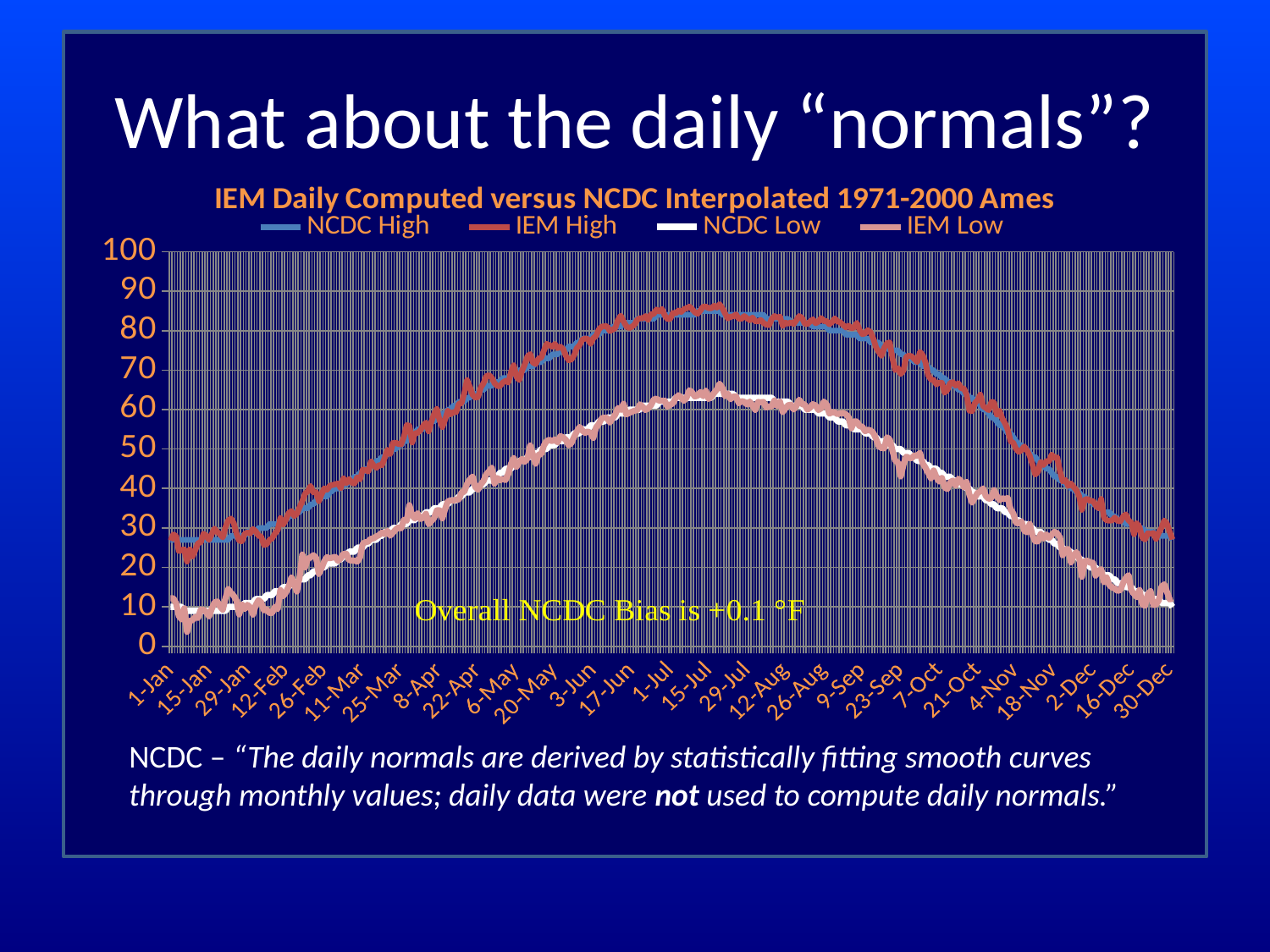
What is the title of the chart? IEM Daily Computed versus NCDC Interpolated 1971-2000 Ames Does the NCDC High series rise or fall from 1-Jan to 15-Jul? rise How many series does the chart legend list? 4 Is the value of NCDC High around 1-Jan greater or less than 40? less What overall NCDC bias is stated in the annotation on the chart? +0.1 °F Around 1-Jul, which is larger: NCDC High or NCDC Low? NCDC High Is the value of IEM High around 8-Apr greater or less than 40? greater What kind of chart is shown on the slide? line chart Is the value of IEM Low around 1-Jul greater or less than 50? greater Does the NCDC Low series rise or fall from 15-Jul to 30-Dec? fall